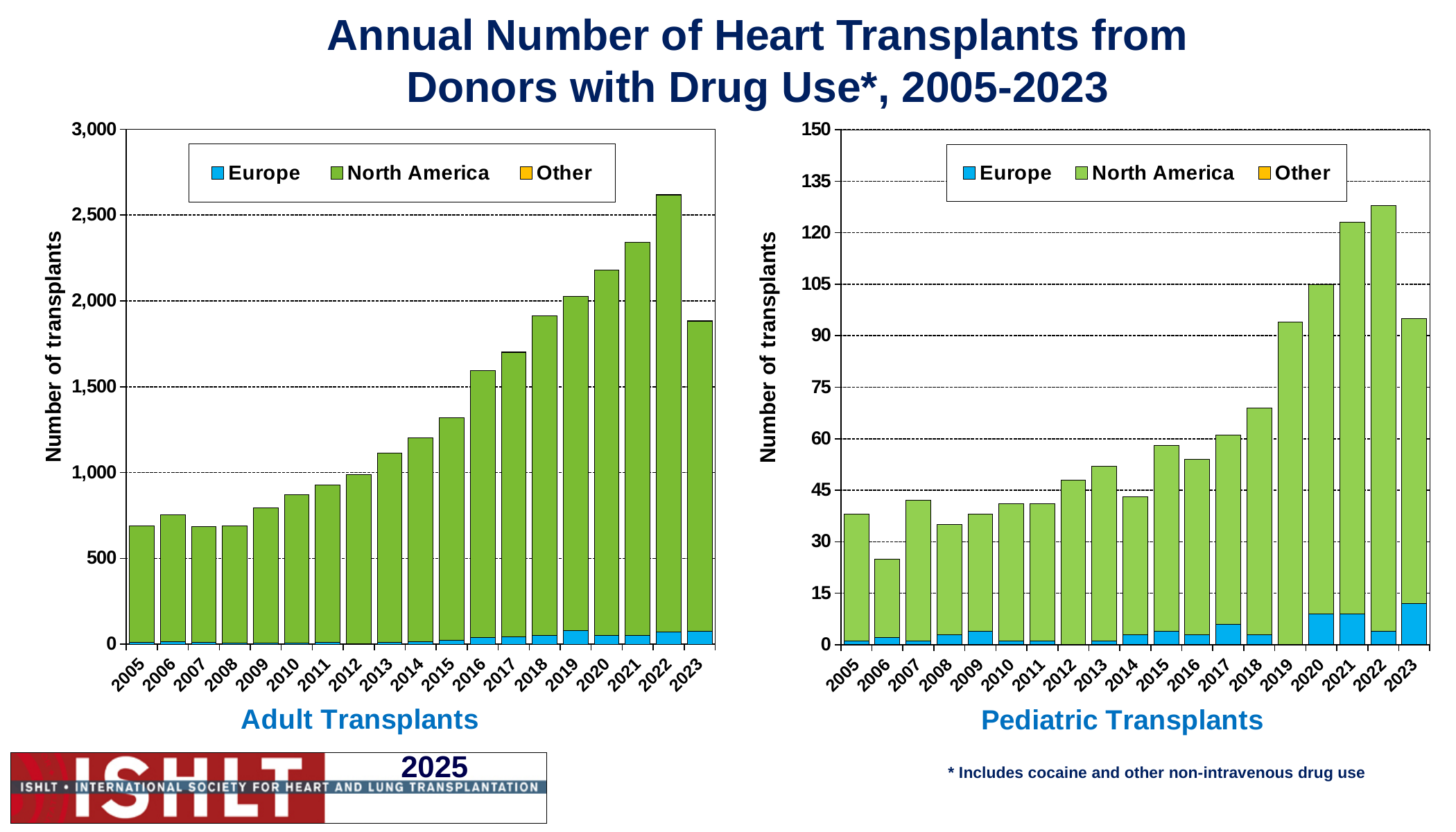
How many years are shown on the x axis of the Adult Transplants chart? 19 In the Adult Transplants chart, which year has the larger total, 2022 or 2023? 2022 In the Adult Transplants chart, is the total for 2023 greater or less than 2,000? less In the Pediatric Transplants chart, which year has the lowest total number of transplants? 2006 In the Adult Transplants chart, do the totals generally rise or fall from 2008 to 2022? rise How many series does the legend of the Pediatric Transplants chart list? 3 In the Adult Transplants chart, is the total for 2022 greater or less than 2,500? greater In the Pediatric Transplants chart, is the total for 2018 greater or less than 60? greater What kind of chart is the Adult Transplants chart? bar chart In the Pediatric Transplants chart, which year has the larger total, 2007 or 2008? 2007 In the Adult Transplants chart, which year has the highest total number of transplants? 2022